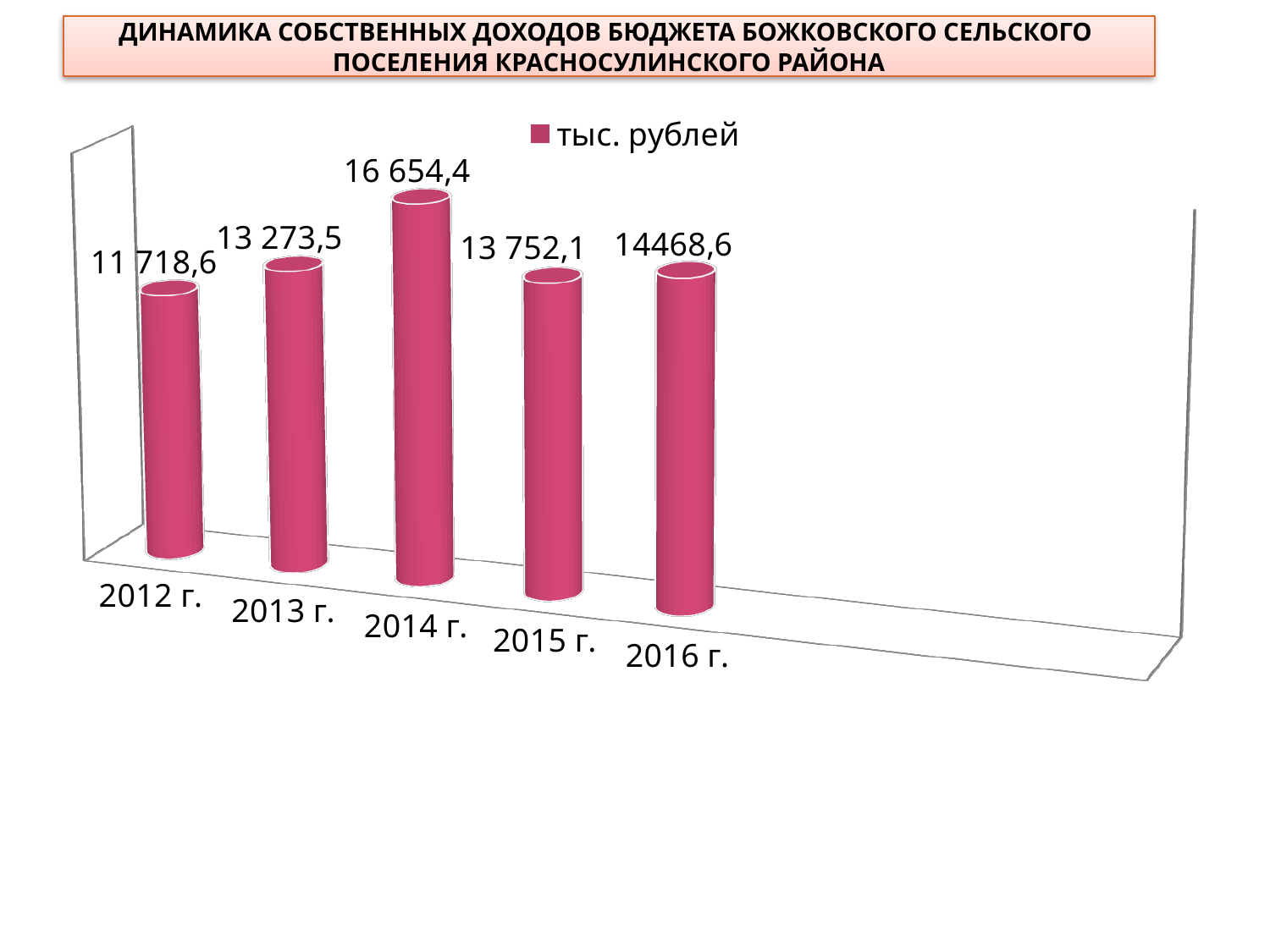
What is the legend entry of the series shown on the chart? тыс. рублей What is the value for 2012 г.? 11 718,6 Which year has the highest value? 2014 г. Which is larger, the value for 2013 г. or the value for 2015 г.? 2015 г. Which year has the lowest value? 2012 г. What is the difference between the values for 2014 г. and 2012 г.? 4 935,8 How many years are shown on the chart? 5 What kind of chart is shown on the slide? bar chart What is the value for 2014 г.? 16 654,4 What is the difference between the values for 2016 г. and 2015 г.? 716,5 What is the value for 2015 г.? 13 752,1 What is the value for 2016 г.? 14468,6